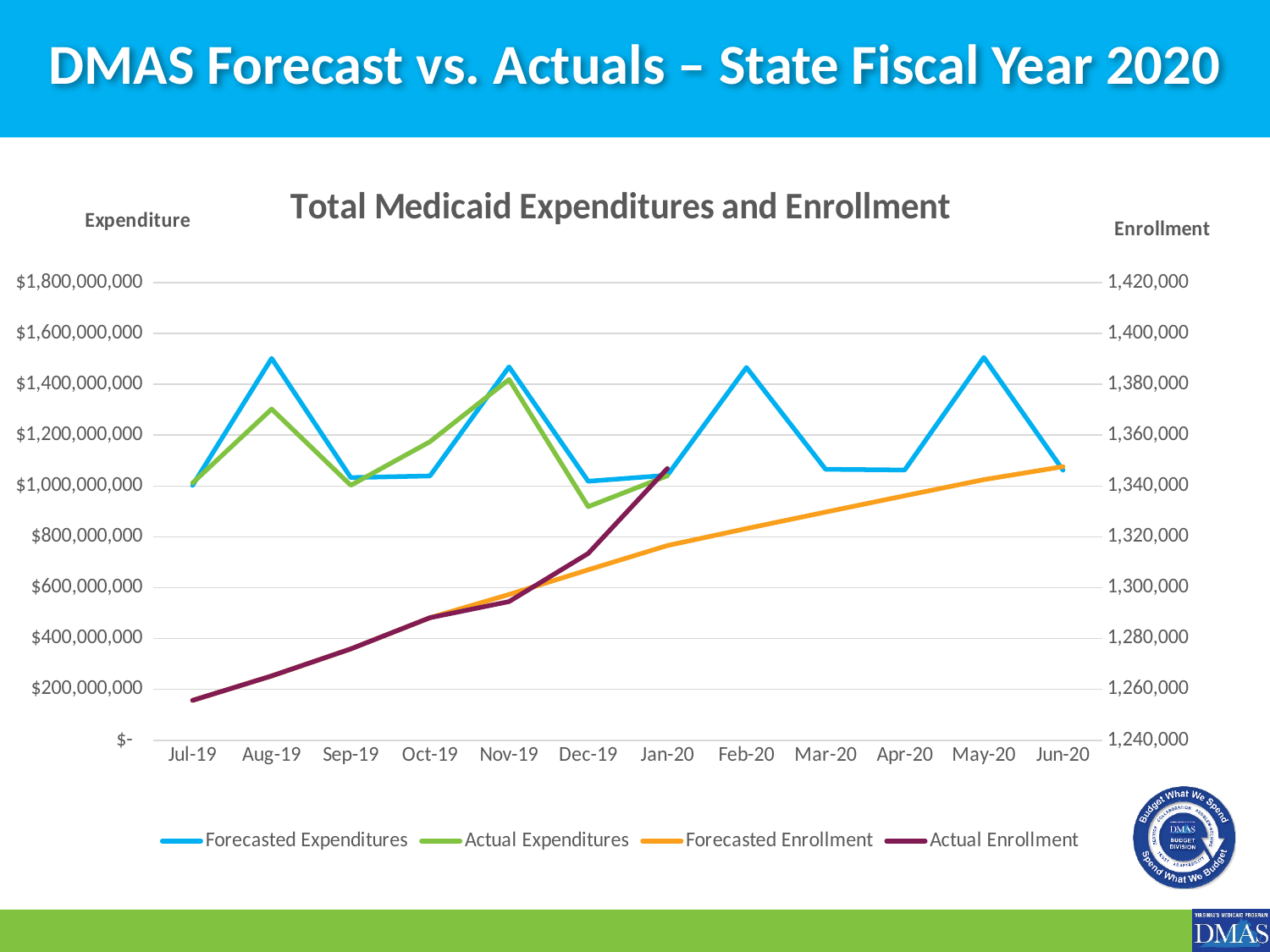
Is the value for Actual Enrollment in Jul-19 greater or less than 1,260,000? less In which month is Actual Expenditures at its lowest? Dec-19 How many series does the legend list? 4 How many months are shown along the x axis? 12 What is the title of the chart? Total Medicaid Expenditures and Enrollment Is the value for Actual Expenditures in Dec-19 greater or less than $1,000,000,000? less What kind of chart is shown on the slide? line chart What is the label of the right-hand vertical axis? Enrollment Is the value for Forecasted Enrollment in Jun-20 greater or less than 1,340,000? greater Does Actual Enrollment rise or fall from Jul-19 to Jan-20? rise In which month is Actual Expenditures at its highest? Nov-19